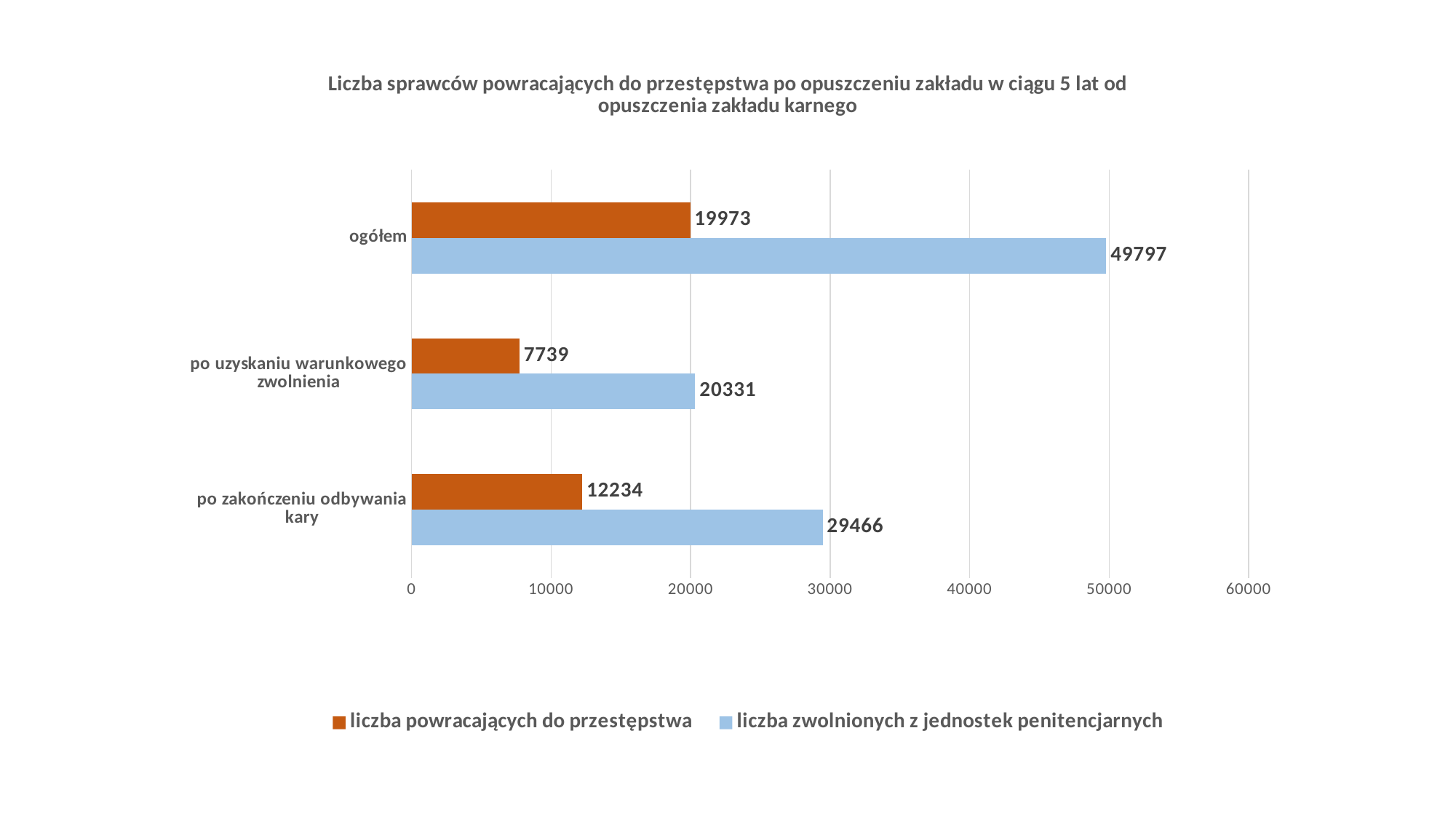
How many categories are shown on the chart? 3 What is the difference between 'liczba zwolnionych z jednostek penitencjarnych' and 'liczba powracających do przestępstwa' for 'ogółem'? 29824 What is the value of 'liczba powracających do przestępstwa' for 'ogółem'? 19973 How many series does the legend list? 2 What is the value of 'liczba zwolnionych z jednostek penitencjarnych' for 'po zakończeniu odbywania kary'? 29466 What is the value of 'liczba zwolnionych z jednostek penitencjarnych' for 'po uzyskaniu warunkowego zwolnienia'? 20331 What is the value of 'liczba powracających do przestępstwa' for 'po zakończeniu odbywania kary'? 12234 Is the value of 'liczba zwolnionych z jednostek penitencjarnych' for 'po zakończeniu odbywania kary' greater or less than 30000? less Which category has the lowest value for 'liczba powracających do przestępstwa'? po uzyskaniu warunkowego zwolnienia Which category has the highest value for 'liczba zwolnionych z jednostek penitencjarnych'? ogółem Which is larger: 'liczba powracających do przestępstwa' for 'po zakończeniu odbywania kary' or for 'po uzyskaniu warunkowego zwolnienia'? po zakończeniu odbywania kary What kind of chart is shown on the slide? bar chart